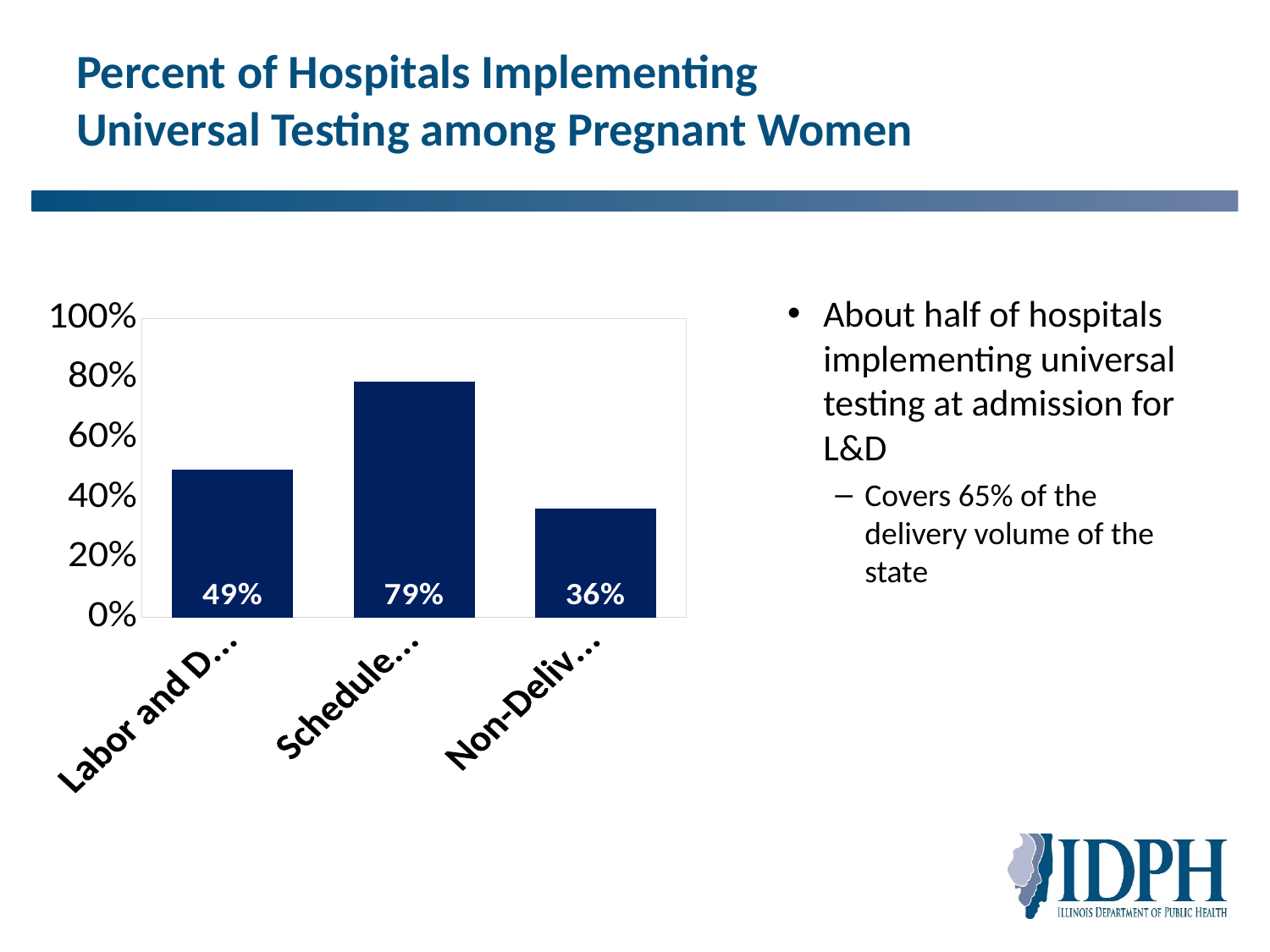
Which bar has the lowest value? the third bar (Non-Deliv...) What is the value shown on the middle bar, labeled "Schedule..."? 79% Is the value of the middle bar greater or less than 60%? greater What type of chart is shown on the slide? bar chart What is the difference between the first bar (49%) and the third bar (36%)? 13 percentage points Which is larger, the value of the first bar or the value of the third bar? the first bar (49%) What is the value shown on the third bar, labeled "Non-Deliv..."? 36% What is the value shown on the first bar, labeled "Labor and D..."? 49% How many bars are plotted in the chart? 3 What is the maximum value shown on the vertical axis? 100% What is the difference between the middle bar (79%) and the first bar (49%)? 30 percentage points Which bar has the highest value? the middle bar (Schedule...)